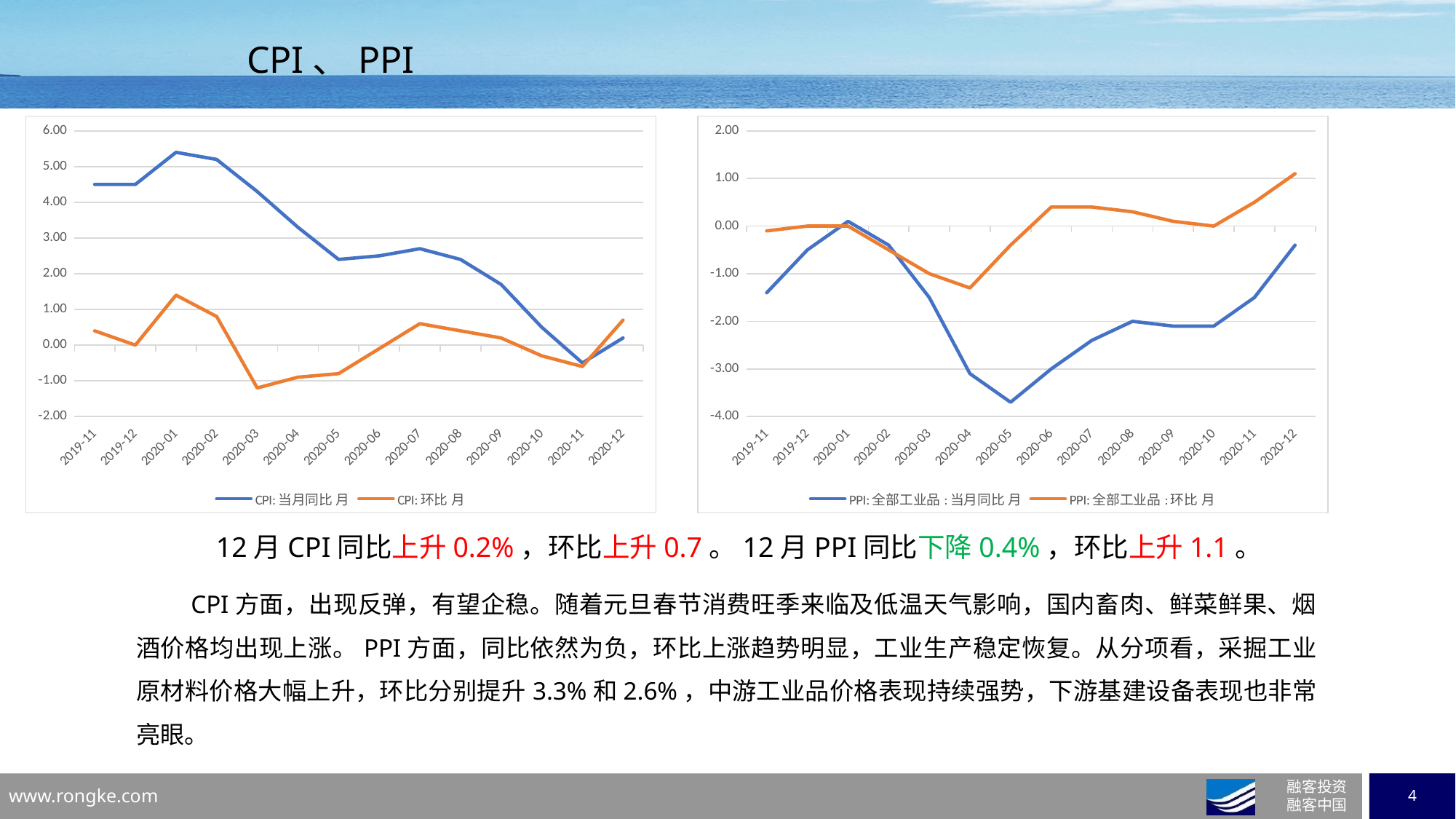
In the left chart (CPI), in which month does the CPI 环比 series reach its lowest value? 2020-03 In the left chart (CPI), in which month does the CPI 当月同比 series reach its highest value? 2020-01 In the right chart (PPI), is the PPI 全部工业品:当月同比 value for 2020-05 greater or less than -3.00? less In the right chart (PPI), in which month does the PPI 全部工业品:环比 series reach its highest value? 2020-12 What type of chart is the left chart (CPI)? line chart How many series does the legend of the right chart (PPI) list? 2 In the left chart (CPI), which series has the higher value in 2020-05, CPI 当月同比 or CPI 环比? CPI 当月同比 In the left chart (CPI), is the CPI 当月同比 value for 2020-01 greater or less than 5.00? greater What colour is the line for the 环比 series in both charts? orange How many months are plotted along the x axis of the left chart (CPI)? 14 In the left chart (CPI), does the CPI 当月同比 series rise or fall from 2020-01 to 2020-11? fall In the right chart (PPI), in which month does the PPI 全部工业品:当月同比 series reach its lowest value? 2020-05